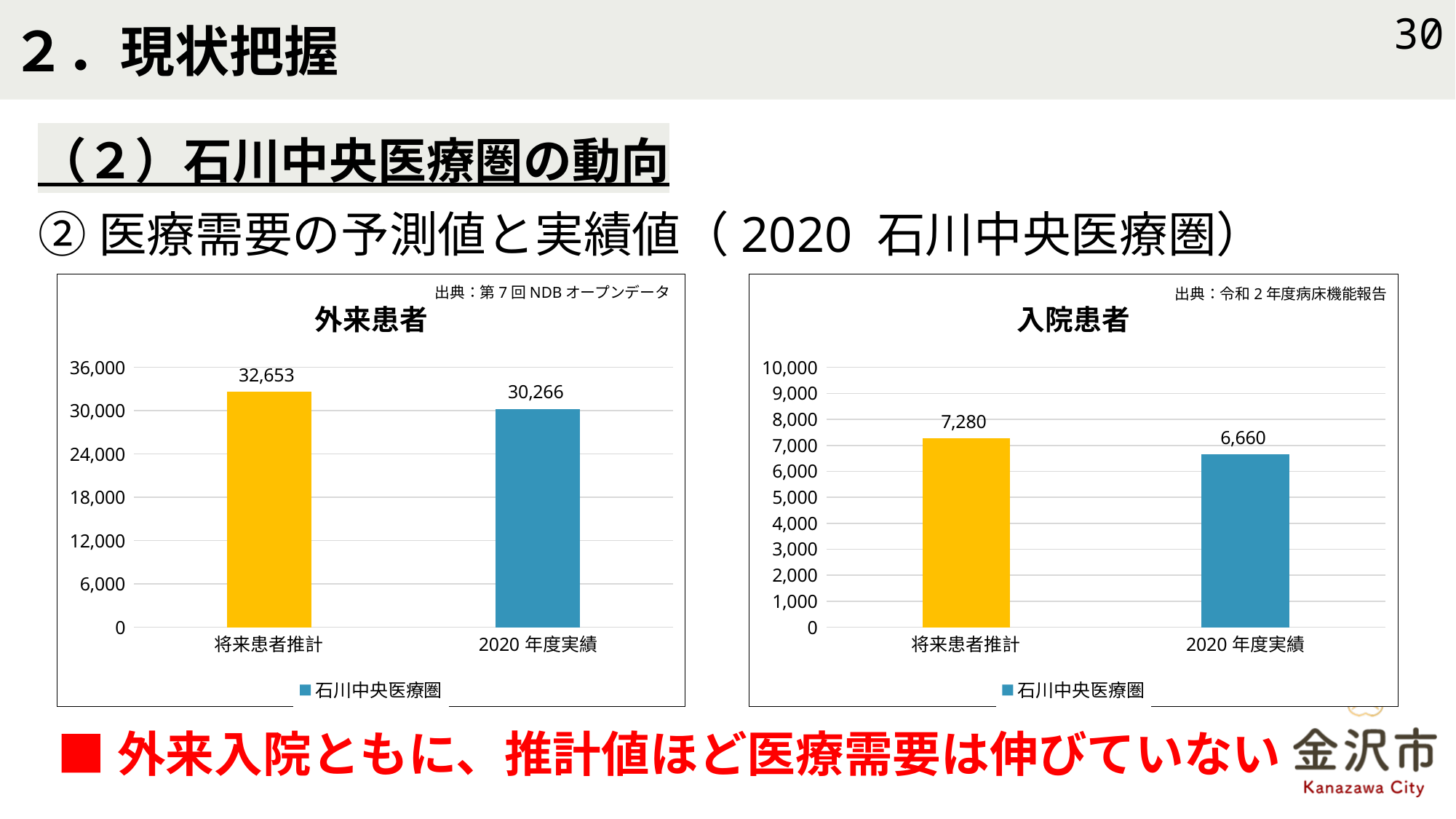
What is the legend entry shown in the 入院患者 chart? 石川中央医療圏 In the 外来患者 chart, what is the value for 2020年度実績? 30,266 In the 入院患者 chart, what is the value for 2020年度実績? 6,660 In the 外来患者 chart, what is the value for 将来患者推計? 32,653 What type of chart is the 外来患者 chart? bar chart In the 外来患者 chart, is the value for 2020年度実績 greater or less than 30,000? greater In the 外来患者 chart, which category has the lower value? 2020年度実績 In the 外来患者 chart, what is the difference between 将来患者推計 and 2020年度実績? 2,387 In the 入院患者 chart, which category has the higher value? 将来患者推計 In the 入院患者 chart, what is the value for 将来患者推計? 7,280 How many bars are shown in the 入院患者 chart? 2 In the 入院患者 chart, what is the difference between 将来患者推計 and 2020年度実績? 620